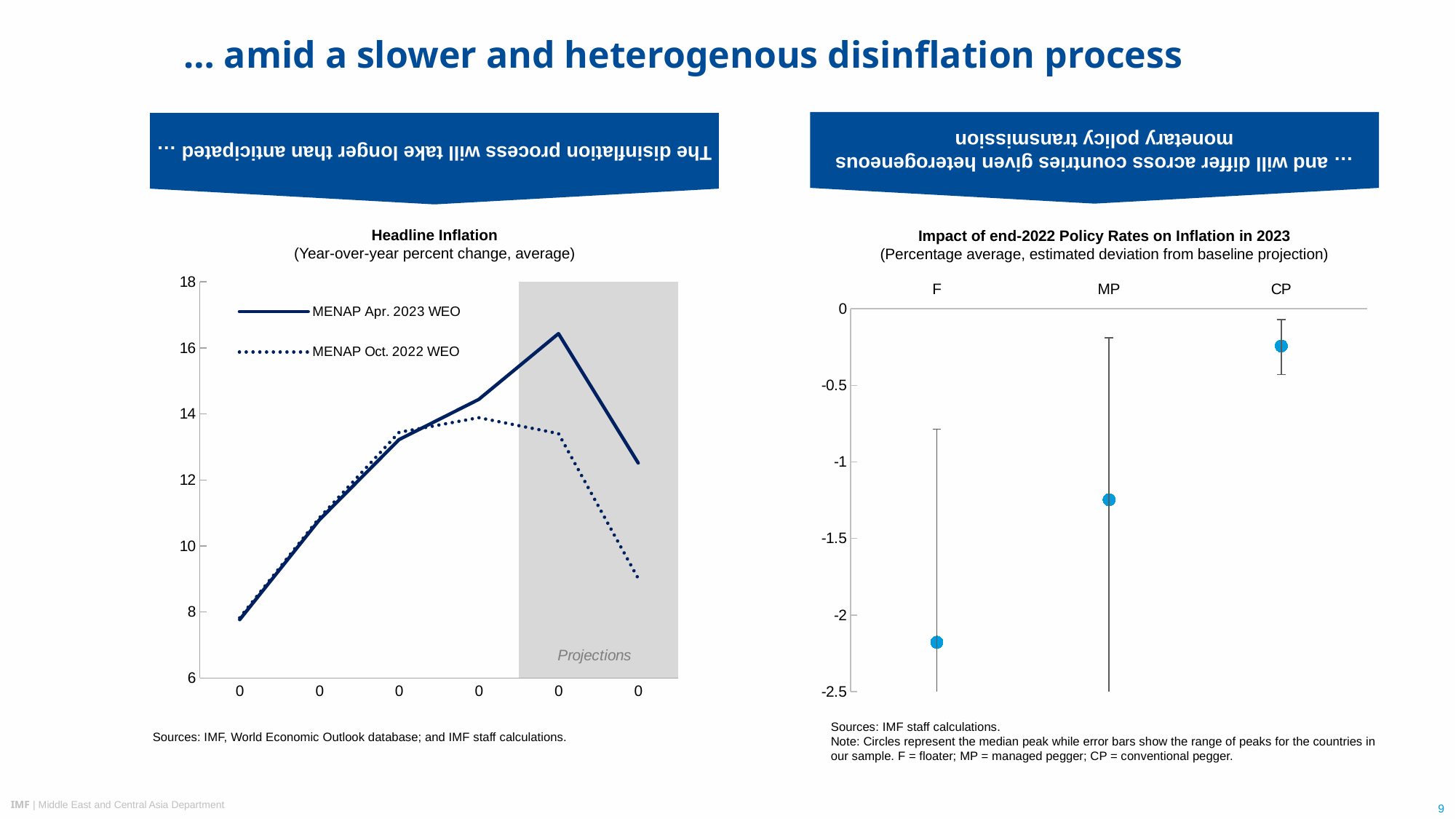
In the Impact of end-2022 Policy Rates on Inflation in 2023 chart, which category has the lowest median (circle) value? F What kind of chart is the Headline Inflation chart on the left? line chart How many series does the legend of the Headline Inflation chart list? 2 How many categories are shown on the x axis of the Impact of end-2022 Policy Rates on Inflation in 2023 chart? 3 In the Headline Inflation chart, which series is higher at the last point on the x axis? MENAP Apr. 2023 WEO In the Headline Inflation chart, which series is drawn with a dotted line? MENAP Oct. 2022 WEO In the Headline Inflation chart, is the final value of the MENAP Oct. 2022 WEO line greater or less than 10? less In the Headline Inflation chart, is the peak value of the MENAP Apr. 2023 WEO line greater or less than 16? greater What label appears in the shaded area of the Headline Inflation chart? Projections In the Impact of end-2022 Policy Rates on Inflation in 2023 chart, which category has the highest median (circle) value? CP In the Impact of end-2022 Policy Rates on Inflation in 2023 chart, is the circle for MP greater or less than -1.5? greater